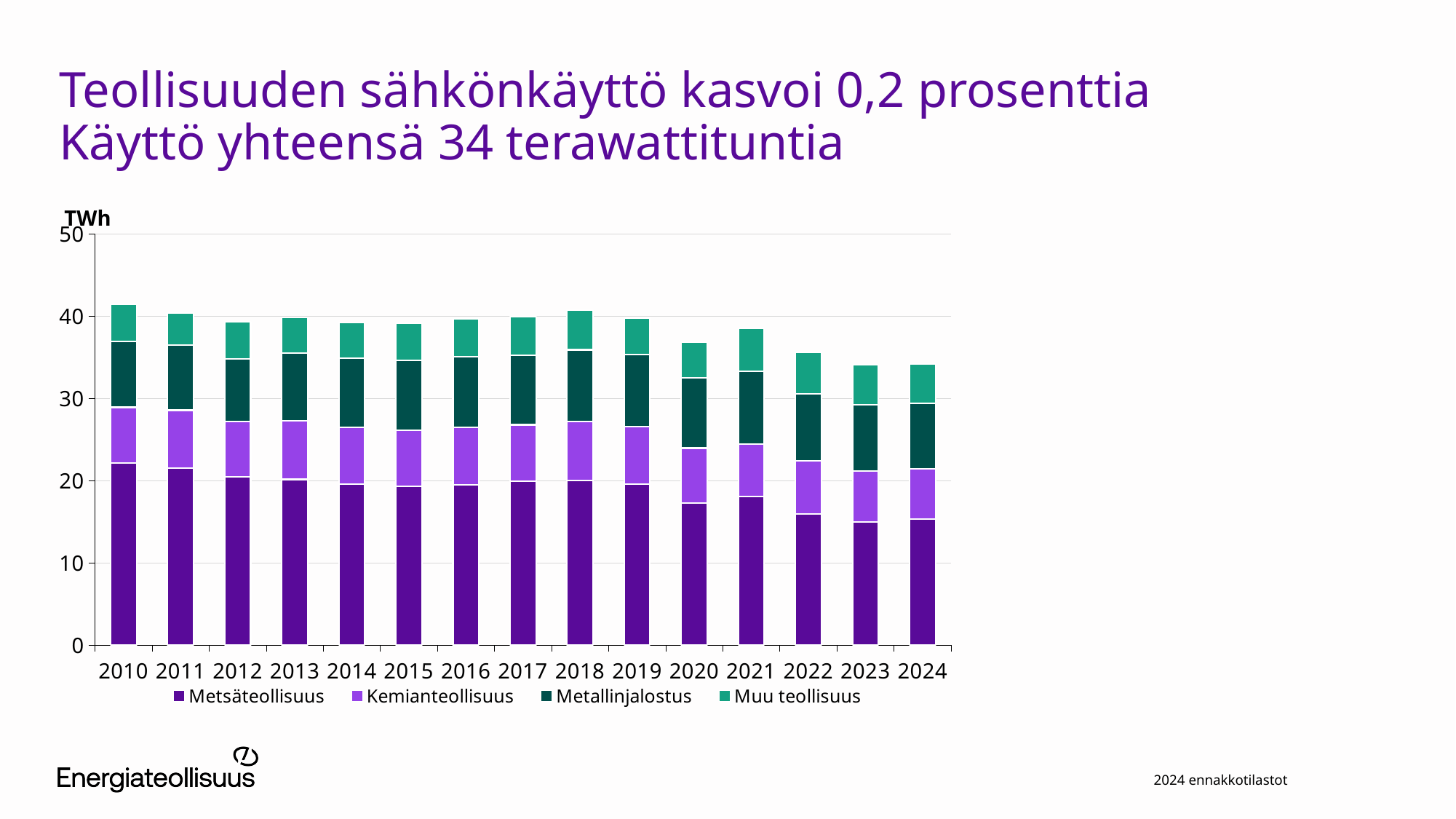
How many years are shown on the x axis of the chart? 15 Is the total value of the stacked bar for 2010 greater or less than 40? greater What kind of chart is shown on the slide? Stacked bar chart Is the Metsäteollisuus value for 2010 greater or less than 20? greater Which series is shown at the bottom of each stacked bar? Metsäteollisuus How many series does the chart's legend list? 4 Is the total value of the stacked bar for 2020 greater or less than 40? less What unit is shown above the y axis of the chart? TWh Do the total bar heights generally rise or fall from 2010 to 2024? Fall Which stacked bar is taller in total, 2010 or 2024? 2010